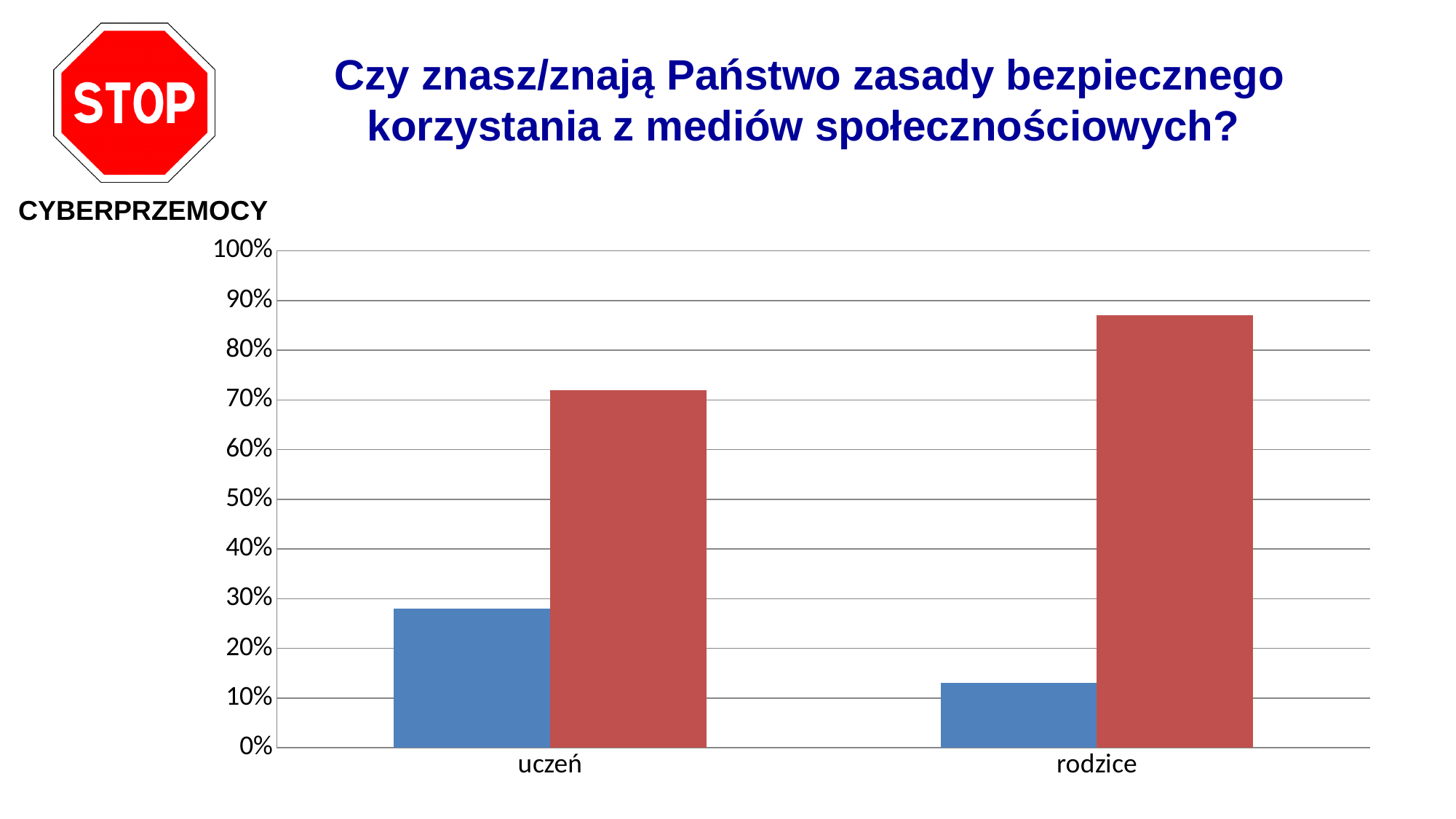
Which category has the taller blue bar, uczeń or rodzice? uczeń Is the value of the blue bar for uczeń greater or less than 20%? greater What is the title of the chart on the slide? Czy znasz/znają Państwo zasady bezpiecznego korzystania z mediów społecznościowych? Is the value of the blue bar for rodzice greater or less than 20%? less Which bar is the tallest in the chart? the red bar for rodzice Which category has the taller red bar, uczeń or rodzice? rodzice What are the two category labels on the x axis? uczeń, rodzice Is the value of the red bar for uczeń greater or less than 60%? greater How many categories are shown on the x axis of the chart? 2 What kind of chart is shown on the slide? bar chart